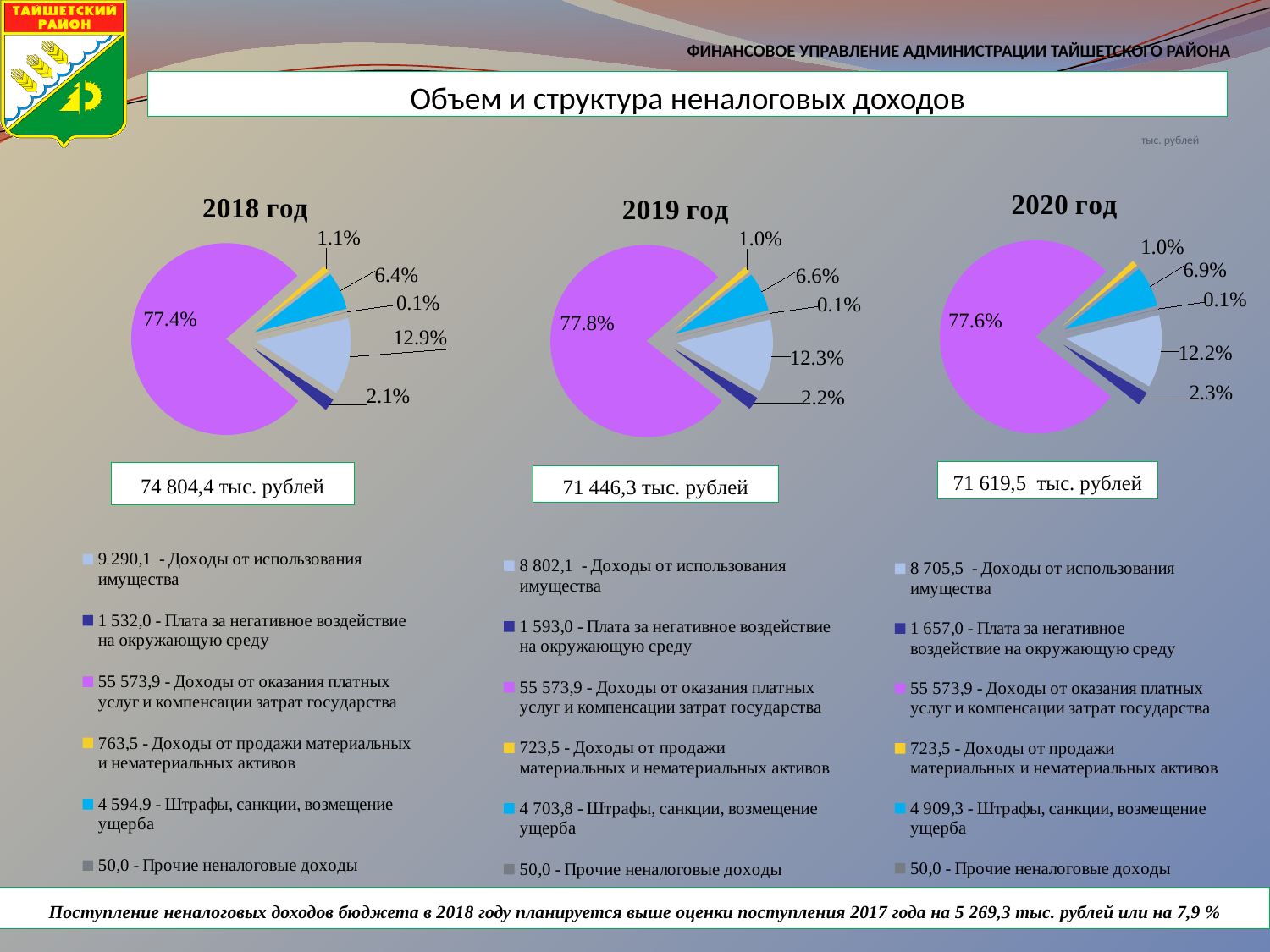
What total amount is shown in the box below the 2020 год pie chart? 71 619,5 тыс. рублей How many entries does the legend of the 2018 год chart list? 6 In the 2018 год pie chart, what share is labelled for the largest slice (Доходы от оказания платных услуг и компенсации затрат государства)? 77.4% How many slices does the 2018 год pie chart have? 6 In the 2018 год chart, what is the difference in percentage points between the Доходы от использования имущества slice (12.9%) and the Штрафы, санкции, возмещение ущерба slice (6.4%)? 6.5 In the 2019 год pie chart, what share is labelled for Доходы от использования имущества? 12.3% In the 2020 год pie chart, what share is labelled for Штрафы, санкции, возмещение ущерба? 6.9% In the 2019 год pie chart, which category has the largest share? Доходы от оказания платных услуг и компенсации затрат государства In the 2020 год pie chart, which category has the smallest share? Прочие неналоговые доходы In the 2020 год chart, which is larger: the share for Плата за негативное воздействие на окружающую среду or the share for Доходы от продажи материальных и нематериальных активов? Плата за негативное воздействие на окружающую среду According to the legend of the 2019 год chart, what is the value for Штрафы, санкции, возмещение ущерба? 4 703,8 What kind of chart is used for the 2018 год chart? pie chart